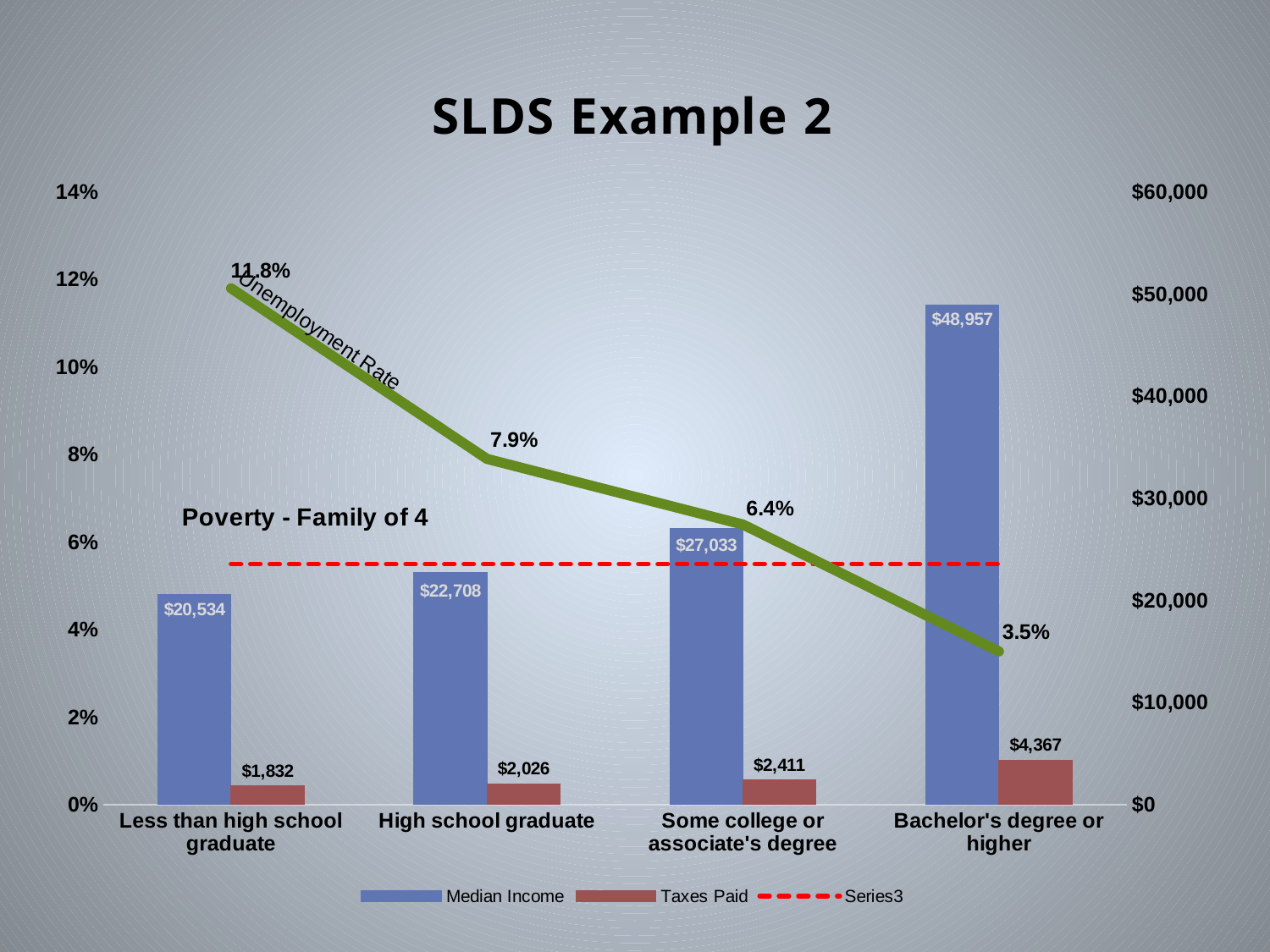
What is the Taxes Paid value for High school graduate? $2,026 What is the unemployment rate for Some college or associate's degree? 6.4% How many series does the legend list? 3 Which education category has the lowest Taxes Paid? Less than high school graduate Does the unemployment rate rise or fall as education level increases along the x axis? fall What is the Median Income for Bachelor's degree or higher? $48,957 Which is larger: Taxes Paid for Some college or associate's degree, or Taxes Paid for Bachelor's degree or higher? Bachelor's degree or higher What is the title of the slide? SLDS Example 2 Is the Median Income for Some college or associate's degree greater or less than $30,000? less What is the difference in Median Income between High school graduate and Less than high school graduate? $2,174 How many education categories are shown on the x axis? 4 Which education category has the highest Median Income? Bachelor's degree or higher